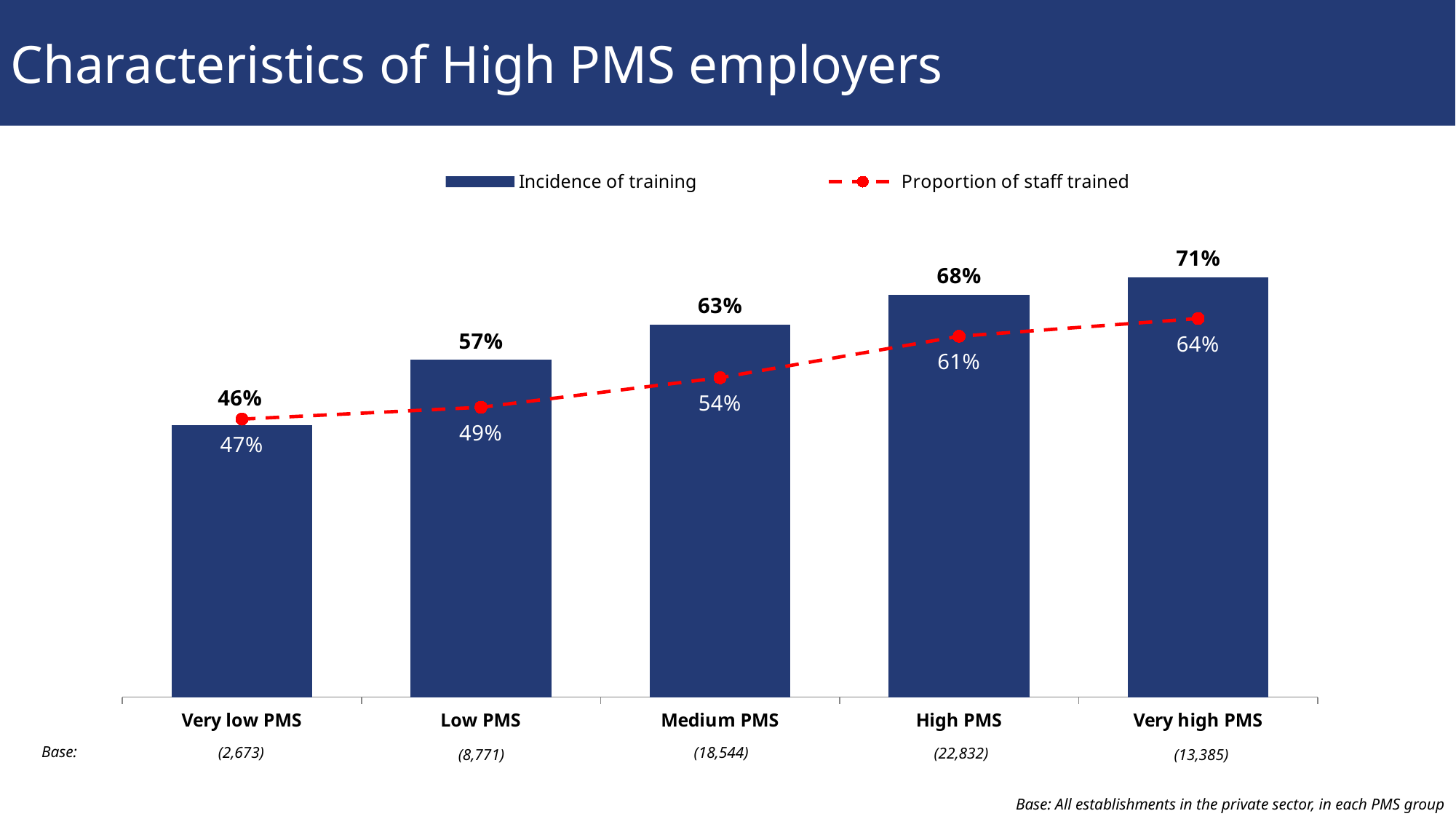
What kind of chart is used to show Incidence of training? Bar chart Does the Proportion of staff trained rise or fall from Very low PMS to Very high PMS? Rise What is the difference in Incidence of training between Very high PMS and Very low PMS employers? 25 percentage points What is the Proportion of staff trained for Very high PMS employers? 64% Which PMS group has the highest Incidence of training? Very high PMS What is the Incidence of training for Very low PMS employers? 46% How many PMS groups are shown on the x axis? 5 How many series does the legend list? 2 Which is larger for Low PMS employers: Incidence of training or Proportion of staff trained? Incidence of training What is the Incidence of training for Medium PMS employers? 63% What is the difference between Incidence of training and Proportion of staff trained for High PMS employers? 7 percentage points Which PMS group has the lowest Proportion of staff trained? Very low PMS